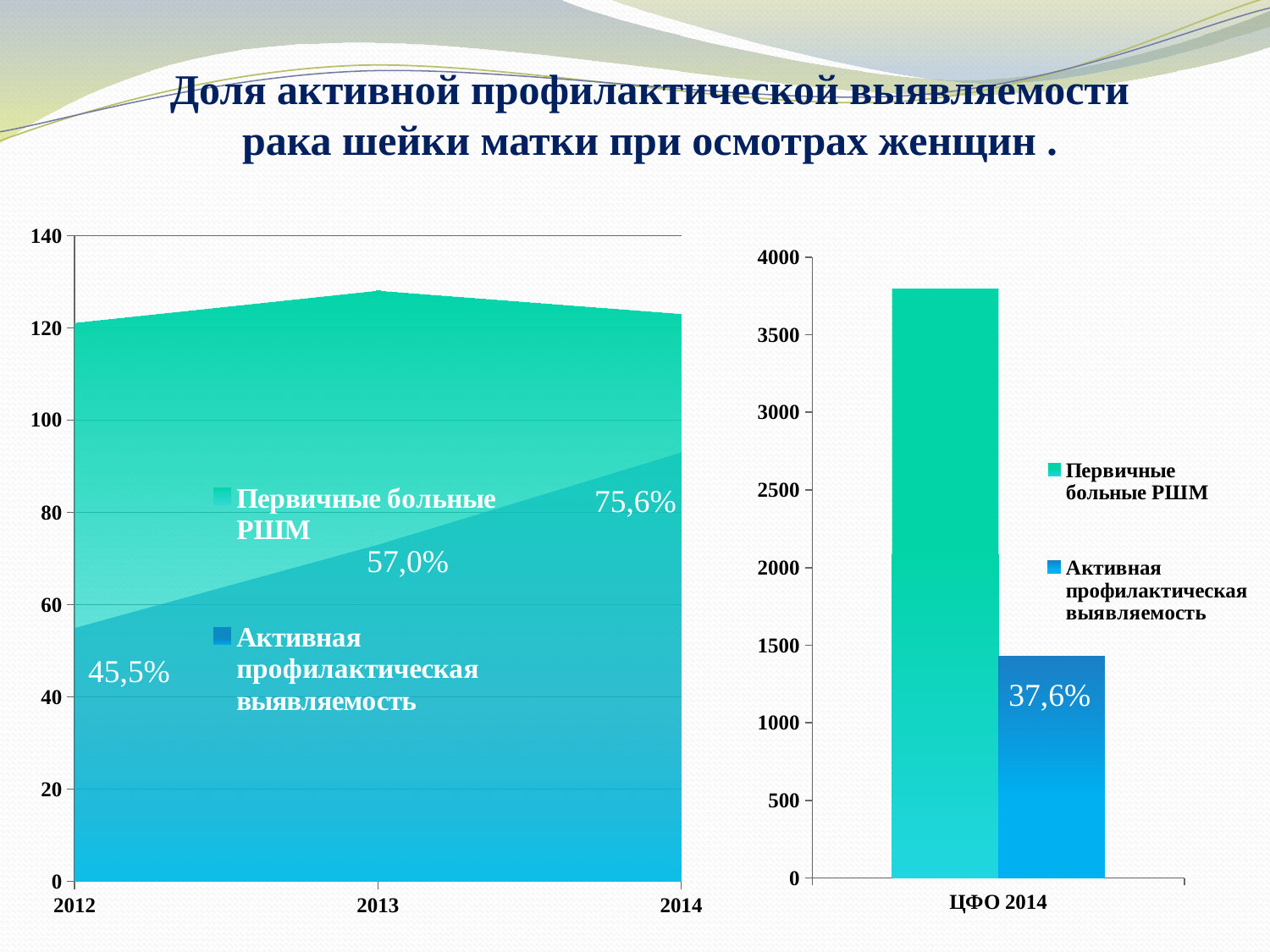
In the right chart, is the value for Первичные больные РШМ greater or less than 3500? greater What kind of chart is the chart on the right of the slide? bar chart What percentage label is printed on the Активная профилактическая выявляемость bar in the right chart? 37,6% How many years are shown on the x axis of the left chart? 3 In the left chart, do the percentage labels rise or fall from 2012 to 2014? rise In the right chart, which series has the taller bar? Первичные больные РШМ How many series does the legend of the right chart list? 2 What category is shown on the x axis of the right chart? ЦФО 2014 What percentage label is printed for 2014 in the left chart? 75,6% What kind of chart is the chart on the left of the slide? area chart How many series does the legend of the left chart list? 2